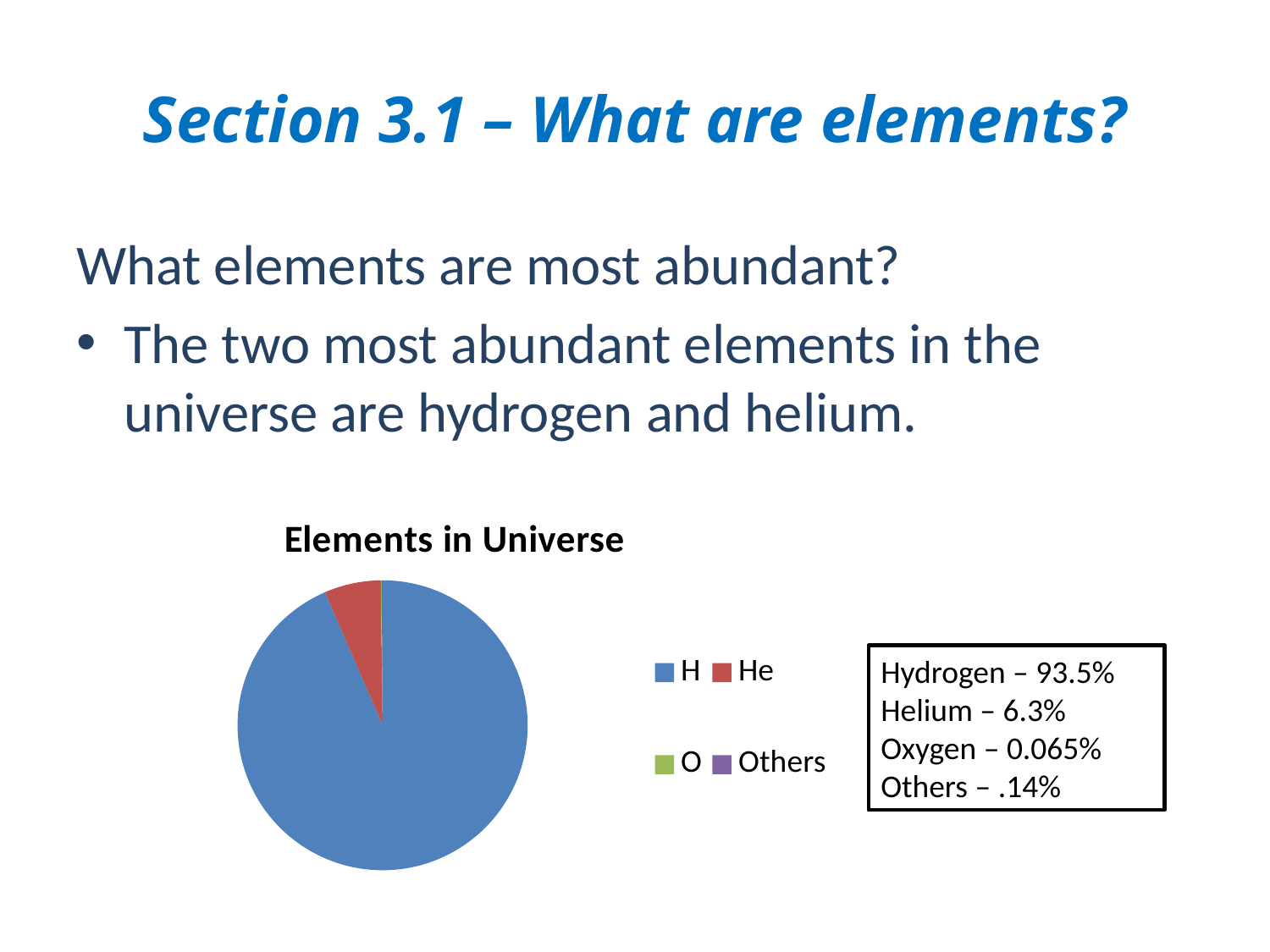
What kind of chart is shown on the slide? pie chart According to the slide, what percentage of the universe's elements is hydrogen? 93.5% Which slice is larger, H or He? H According to the slide, what percentage of the universe's elements is oxygen? 0.065% What colour is the H slice in the pie chart? blue According to the slide, what percentage of the universe's elements is 'Others'? .14% What is the difference in percentage points between hydrogen and helium? 87.2 How many entries does the chart's legend list? 4 Which element has the largest slice in the pie chart? H Which element has the smallest share according to the percentages listed on the slide? Oxygen According to the slide, what percentage of the universe's elements is helium? 6.3% What is the title of the chart? Elements in Universe